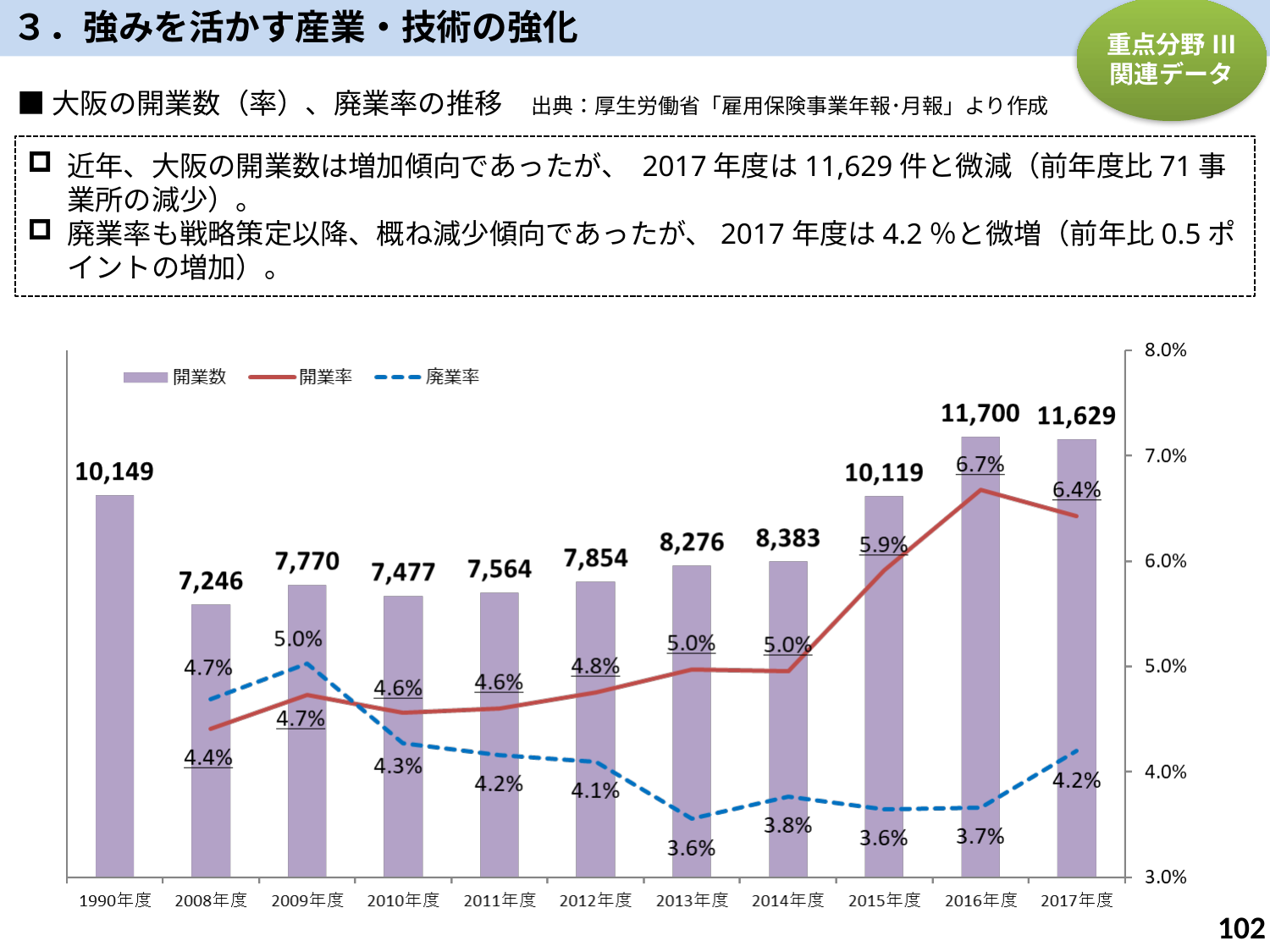
What kind of chart is used to show 開業数? Bar chart Which year has the highest 開業数? 2016年度 What is the difference in 開業数 between 2016年度 and 2017年度? 71 Which year has the lowest 開業数? 2008年度 What is the value of 開業数 for 2017年度? 11,629 Which series is drawn as a blue dashed line? 廃業率 How many fiscal years are shown on the x axis? 11 What is the 開業率 for 2016年度? 6.7% What is the 廃業率 for 2013年度? 3.6% How many series does the legend list? 3 Does the 開業率 rise or fall from 2014年度 to 2016年度? Rise Which is larger, the 開業数 for 1990年度 or for 2015年度? 1990年度